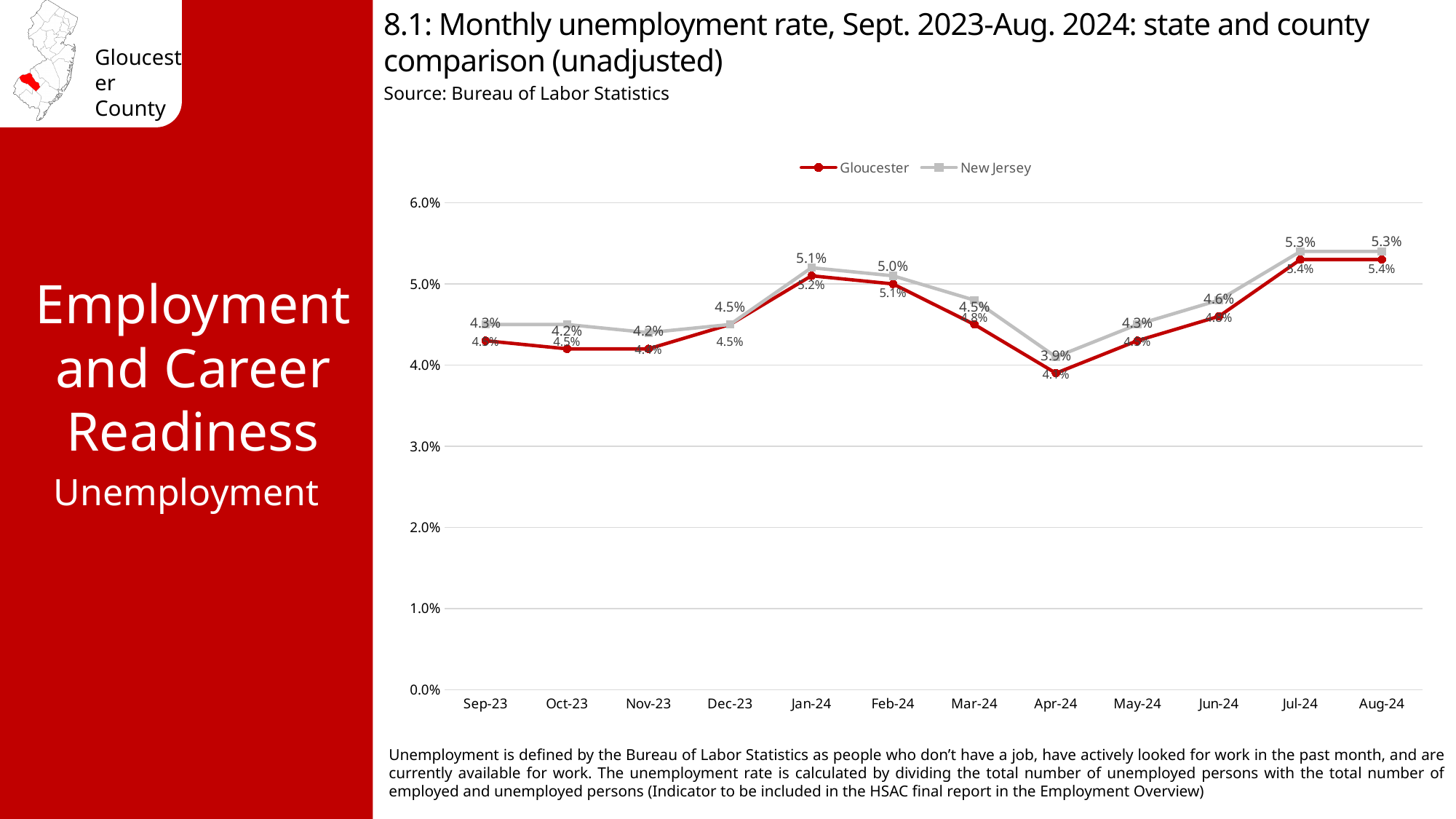
Does the Gloucester unemployment rate rise or fall from Apr-24 to Jul-24? rise How many months are plotted on the x axis? 12 Is the Gloucester unemployment rate for Apr-24 greater or less than 4.0%? less What is the New Jersey unemployment rate for Mar-24? 4.8% What is the Gloucester unemployment rate for Apr-24? 3.9% In Feb-24, which has the higher unemployment rate, Gloucester or New Jersey? New Jersey What is the Gloucester unemployment rate for Jan-24? 5.1% How many series does the legend list? 2 In which month is the Gloucester unemployment rate lowest? Apr-24 What is the New Jersey unemployment rate for Aug-24? 5.4% What kind of chart is shown on the slide? line chart What is the difference between the New Jersey and Gloucester unemployment rates in Mar-24? 0.3 percentage points